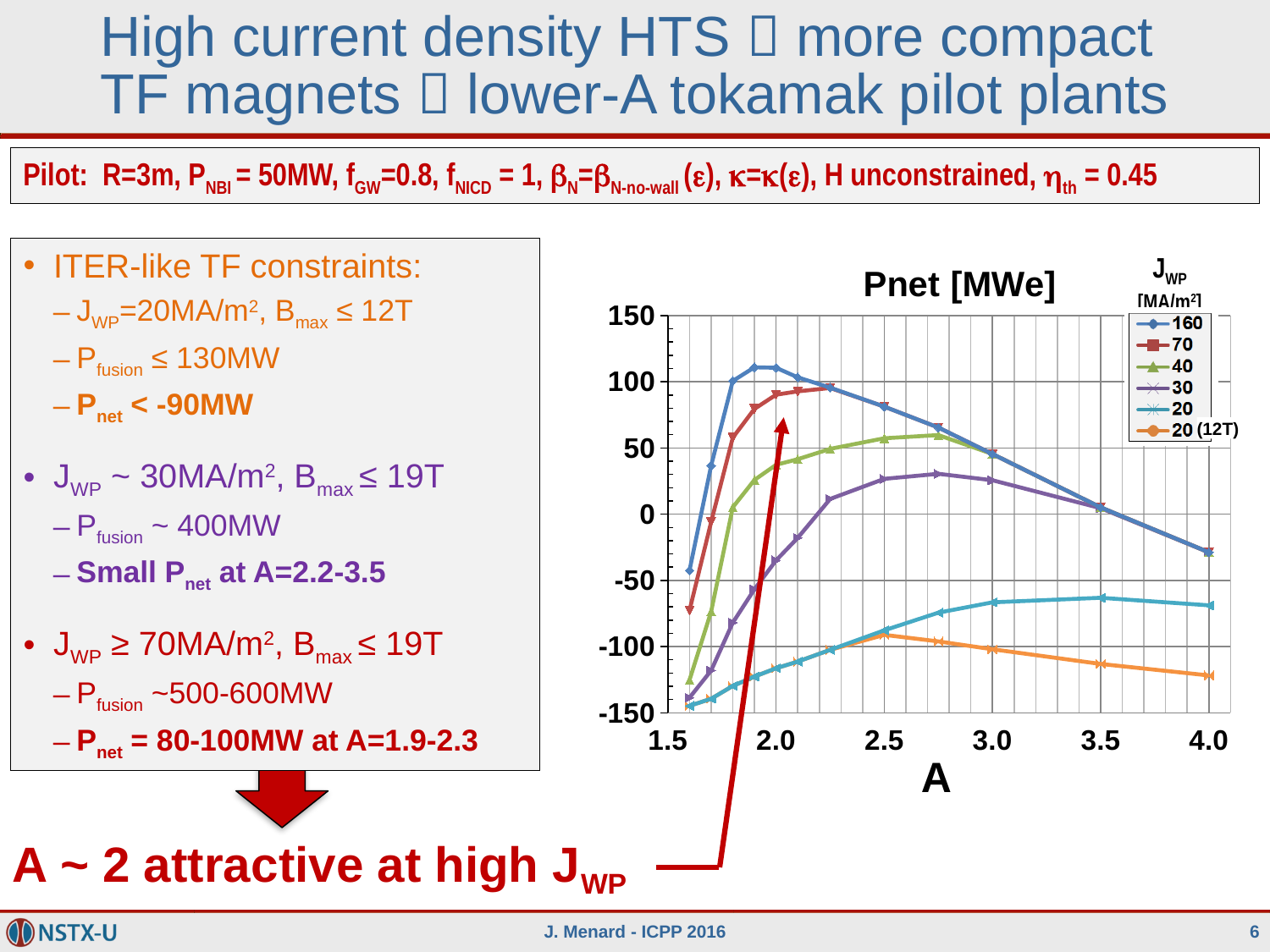
Does the 160 series rise or fall as A increases from 2.0 to 4.0? fall Is the value of the 160 series at A=2.0 greater or less than 100? greater What kind of chart is shown on the slide? line chart Which series has the highest value at A=2.0? 160 What are the legend entries of the chart? 160, 70, 40, 30, 20, 20 (12T) Which series has the lowest value at A=4.0? 20 (12T) Is the value of the 40 series at A=3.0 greater or less than 0? greater How many series does the legend of the Pnet [MWe] chart list? 6 What is the title of the chart? Pnet [MWe] Is the value of the 70 series at A=3.5 greater or less than 50? less At A=2.5, which series has the higher value, 160 or 30? 160